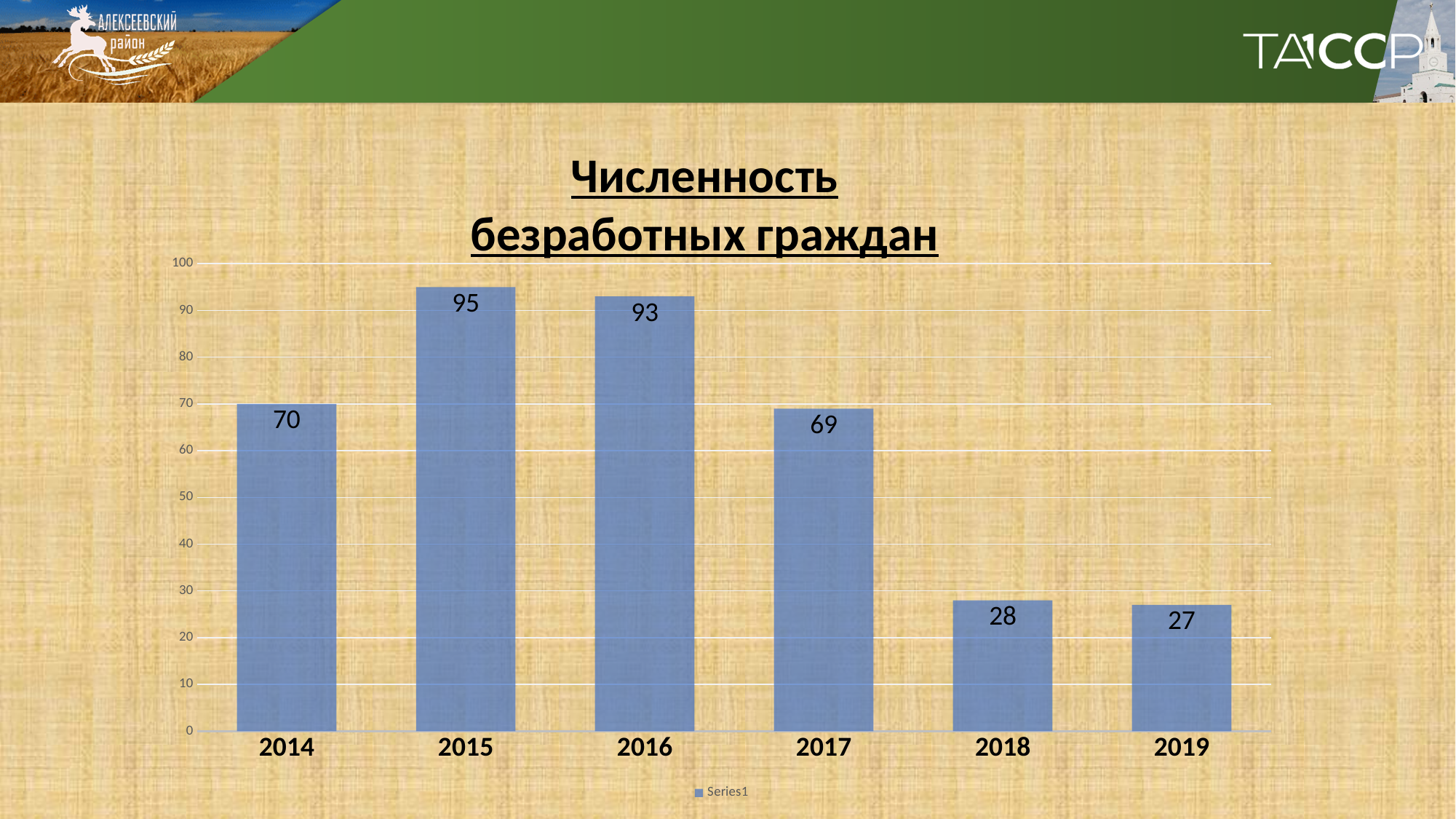
What is the value for 2017? 69 Which year has the lowest value? 2019 What is the difference between the values for 2014 and 2017? 1 Which year has the highest value? 2015 Which is larger, the value for 2016 or the value for 2017? 2016 Is the value for 2018 greater or less than 30? less What is the value for 2015? 95 What is the value for 2019? 27 What kind of chart is shown on the slide? bar chart What is the title of the chart? Численность безработных граждан What is the difference between the values for 2015 and 2018? 67 How many years are shown on the x axis? 6